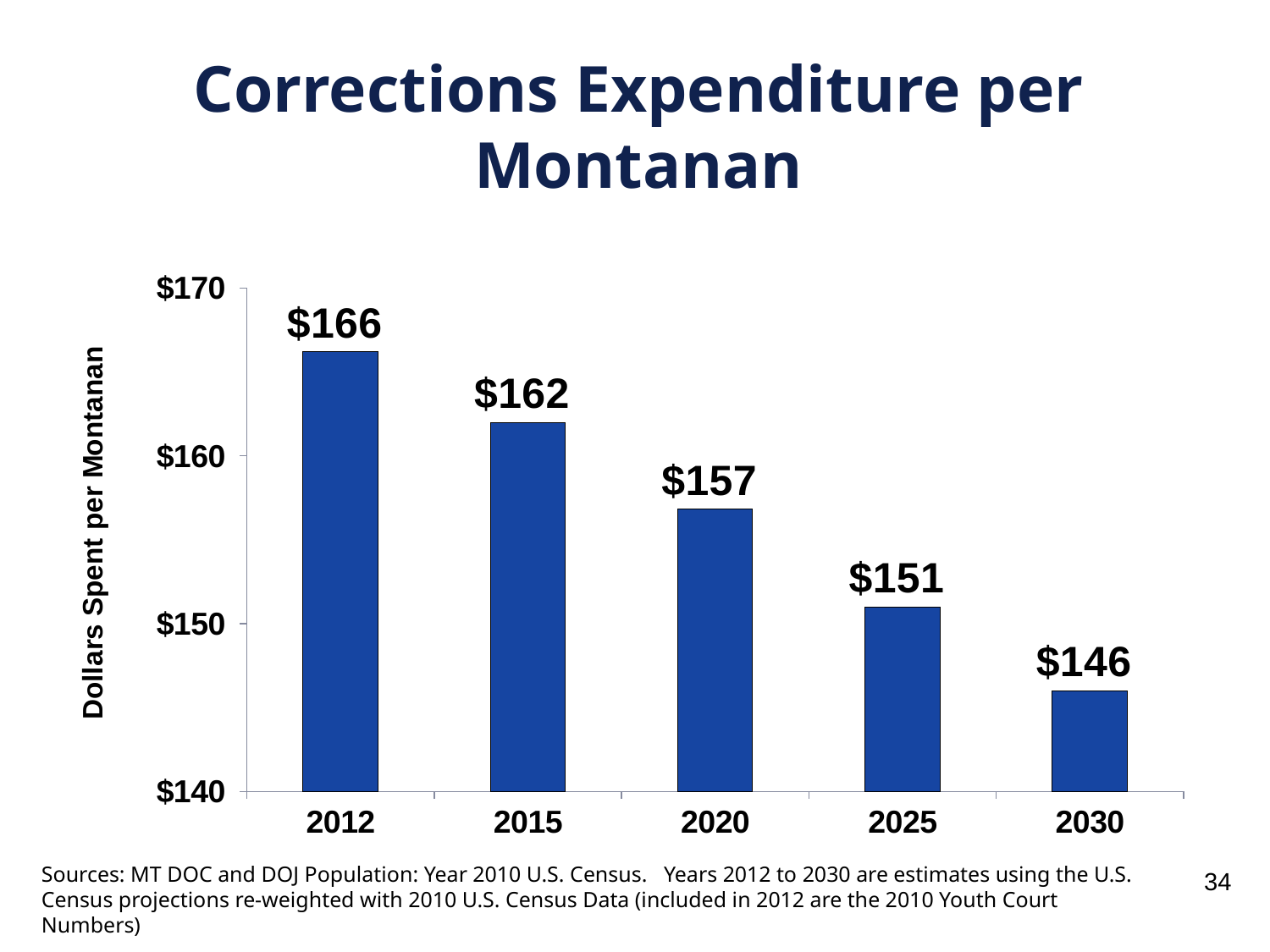
Which is larger, the expenditure per Montanan in 2015 or in 2025? 2015 What is the difference between the expenditure per Montanan in 2012 and in 2030? $20 What is the corrections expenditure per Montanan in 2020? $157 What kind of chart is shown on the slide? bar chart What is the corrections expenditure per Montanan in 2012? $166 Which year has the lowest corrections expenditure per Montanan? 2030 What is the corrections expenditure per Montanan in 2030? $146 Do the values rise or fall from 2012 to 2030? fall Is the value for 2025 greater or less than $160? less How many years are shown on the x axis? 5 Which year has the highest corrections expenditure per Montanan? 2012 What is the difference between the expenditure per Montanan in 2015 and in 2025? $11